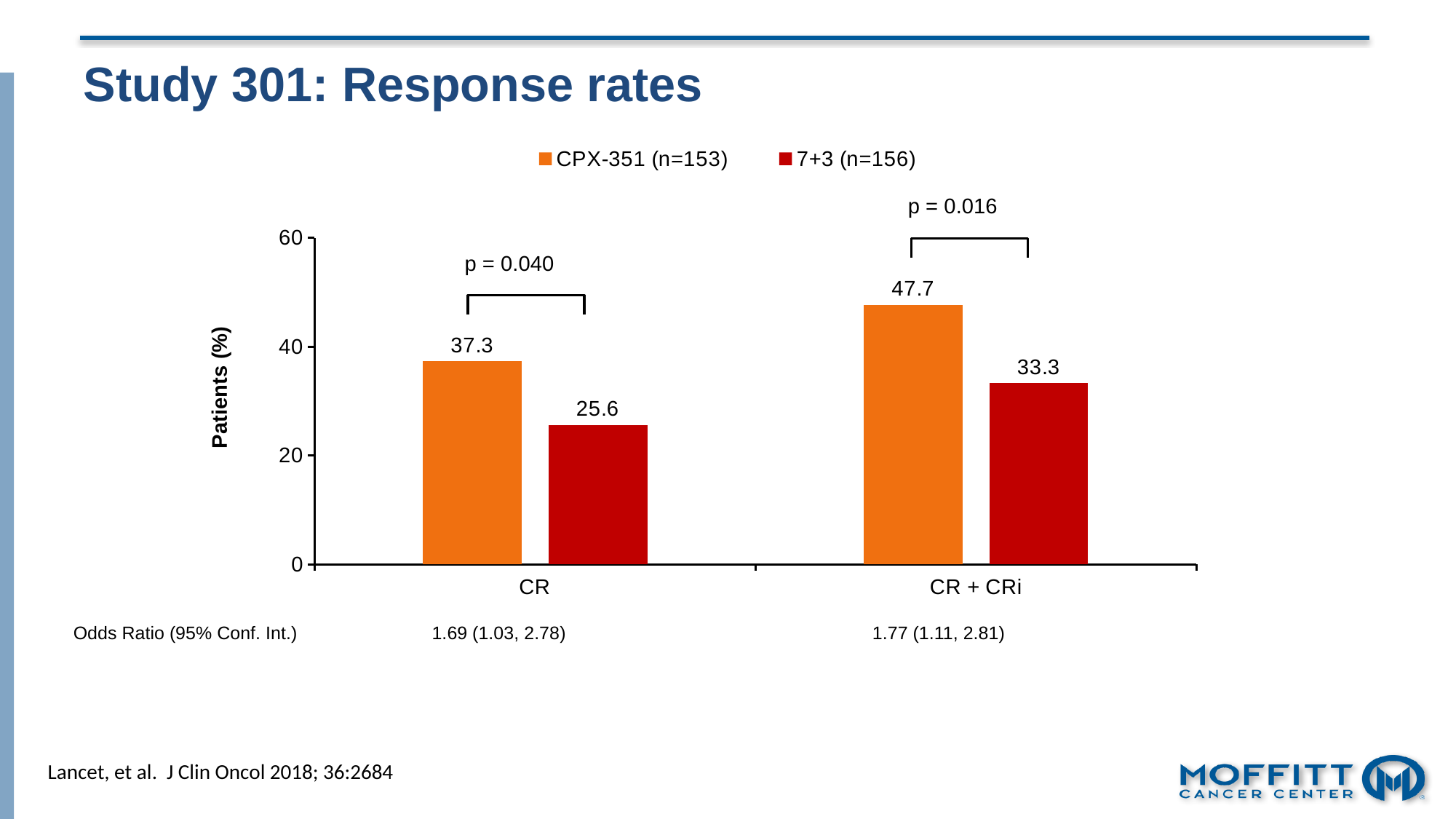
What is the CR rate for CPX-351 (n=153)? 37.3 How many series does the legend list? 2 What kind of chart is shown on the slide? bar chart Which bar has the highest value on the chart? CPX-351 (n=153), CR + CRi What is the difference between the CPX-351 and 7+3 values for CR + CRi? 14.4 What is the CR + CRi rate for 7+3 (n=156)? 33.3 How many categories are shown on the x axis? 2 Is the CR + CRi value for CPX-351 greater or less than 40? greater For CR, which treatment has the larger value, CPX-351 or 7+3? CPX-351 What is the p-value shown for the CR comparison? p = 0.040 What is the CR rate for 7+3 (n=156)? 25.6 Which bar has the lowest value on the chart? 7+3 (n=156), CR